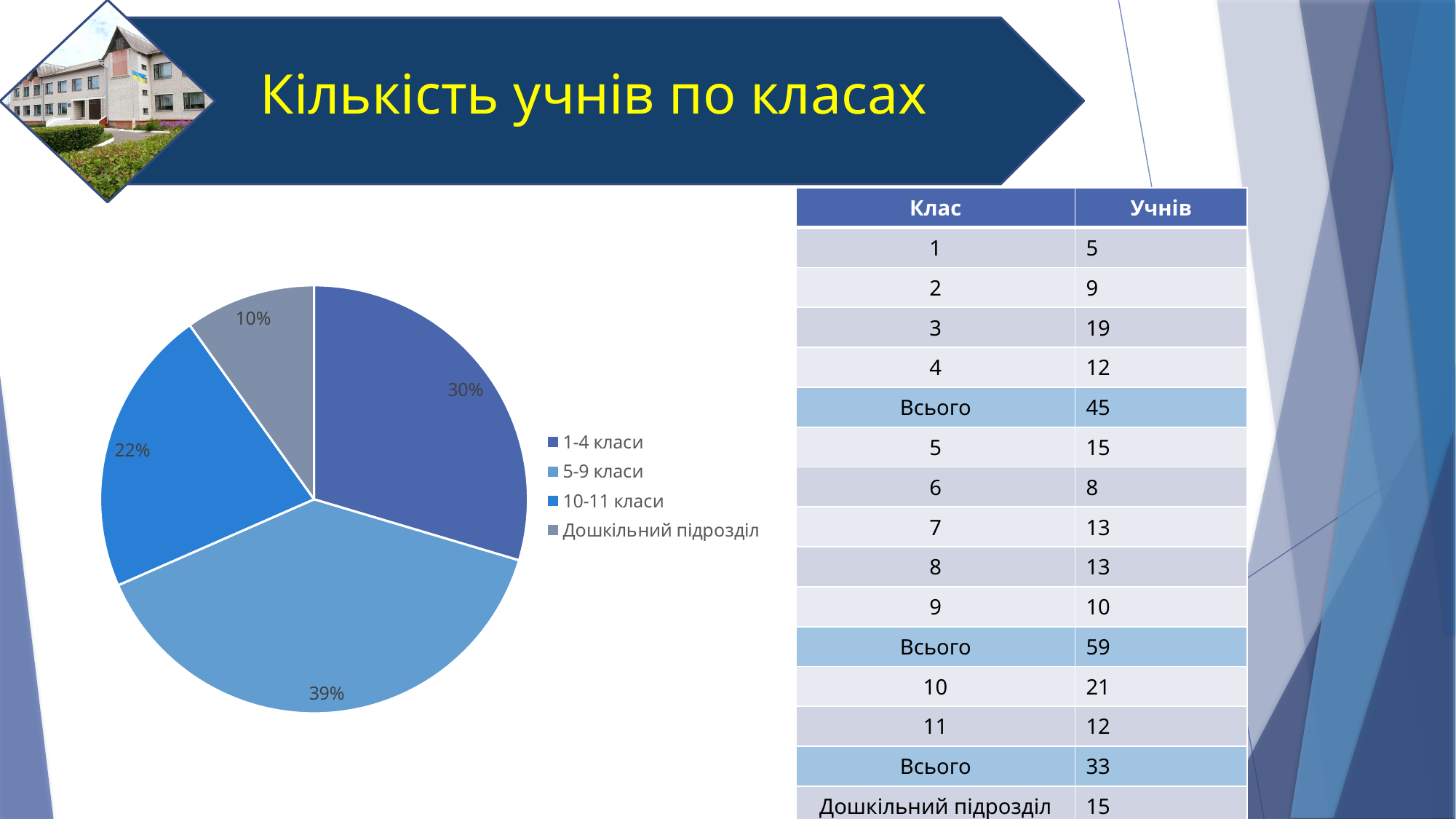
Which category has the largest slice in the pie chart? 5-9 класи Which slice is larger, "10-11 класи" or "Дошкільний підрозділ"? 10-11 класи What is the difference in percentage points between the "5-9 класи" slice and the "1-4 класи" slice? 9 What share of the pie chart does "1-4 класи" have? 30% What share of the pie chart does "10-11 класи" have? 22% What share of the pie chart does "5-9 класи" have? 39% What kind of chart is shown on the slide? pie chart How many slices does the pie chart have? 4 How many entries does the pie chart legend list? 4 What is the title of the slide containing the pie chart? Кількість учнів по класах Which category has the smallest slice in the pie chart? Дошкільний підрозділ